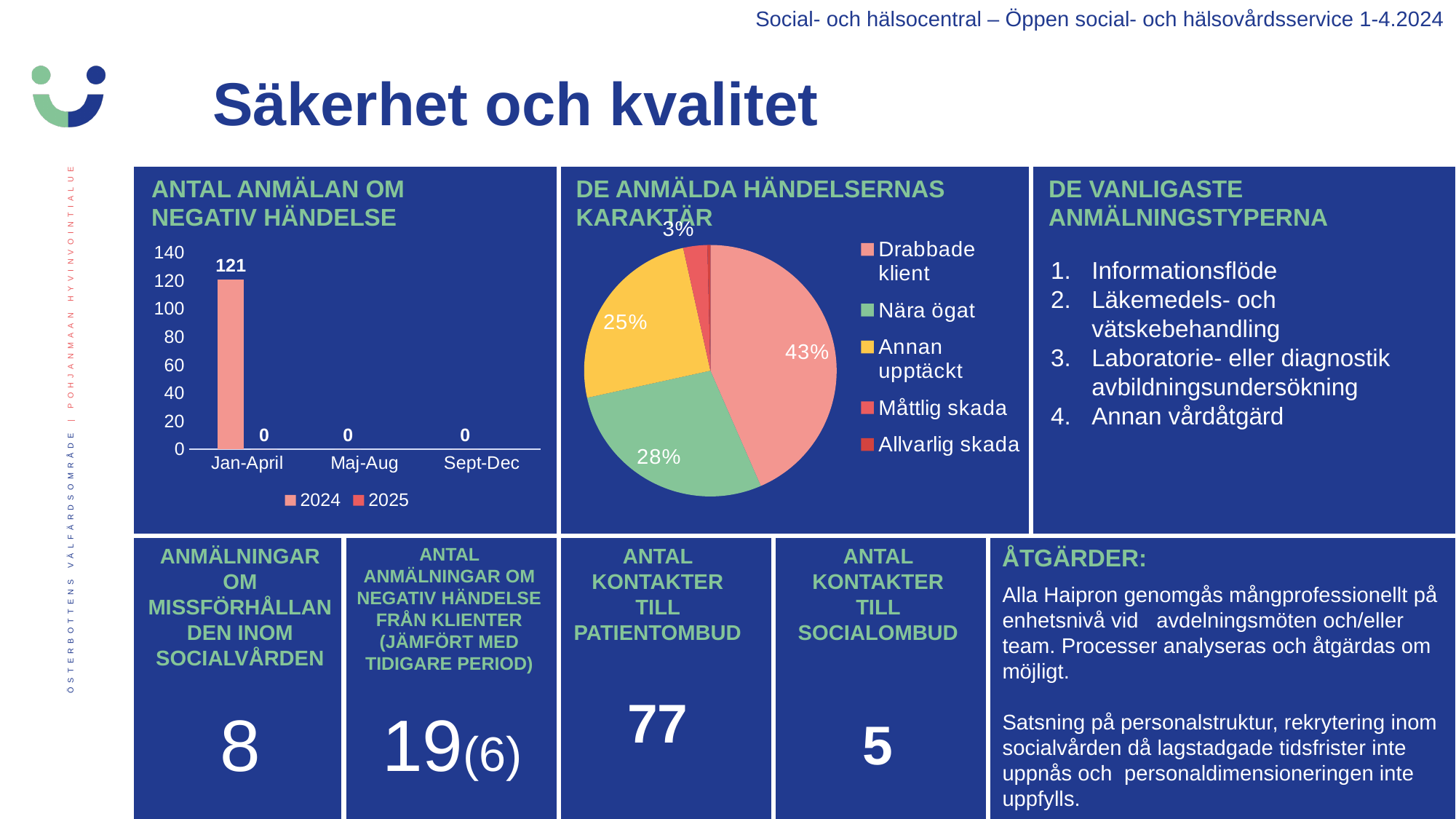
In the pie chart titled 'DE ANMÄLDA HÄNDELSERNAS KARAKTÄR', what is the difference in percentage points between 'Drabbade klient' and 'Annan upptäckt'? 18 In the pie chart titled 'DE ANMÄLDA HÄNDELSERNAS KARAKTÄR', which is larger: 'Nära ögat' or 'Annan upptäckt'? Nära ögat In the pie chart titled 'DE ANMÄLDA HÄNDELSERNAS KARAKTÄR', how many entries does the legend list? 5 In the chart titled 'ANTAL ANMÄLAN OM NEGATIV HÄNDELSE', is the value for Jan-April greater or less than 100? greater In the chart titled 'ANTAL ANMÄLAN OM NEGATIV HÄNDELSE', how many series does the legend list? 2 In the pie chart titled 'DE ANMÄLDA HÄNDELSERNAS KARAKTÄR', what share does 'Drabbade klient' have? 43% In the pie chart titled 'DE ANMÄLDA HÄNDELSERNAS KARAKTÄR', what share does 'Nära ögat' have? 28% In the chart titled 'ANTAL ANMÄLAN OM NEGATIV HÄNDELSE', which category has the highest value? Jan-April In the chart titled 'ANTAL ANMÄLAN OM NEGATIV HÄNDELSE', how many categories are shown on the x axis? 3 What kind of chart is 'ANTAL ANMÄLAN OM NEGATIV HÄNDELSE'? Bar chart In the chart titled 'ANTAL ANMÄLAN OM NEGATIV HÄNDELSE', what is the value shown for Maj-Aug? 0 In the chart titled 'ANTAL ANMÄLAN OM NEGATIV HÄNDELSE', what is the value for Jan-April? 121